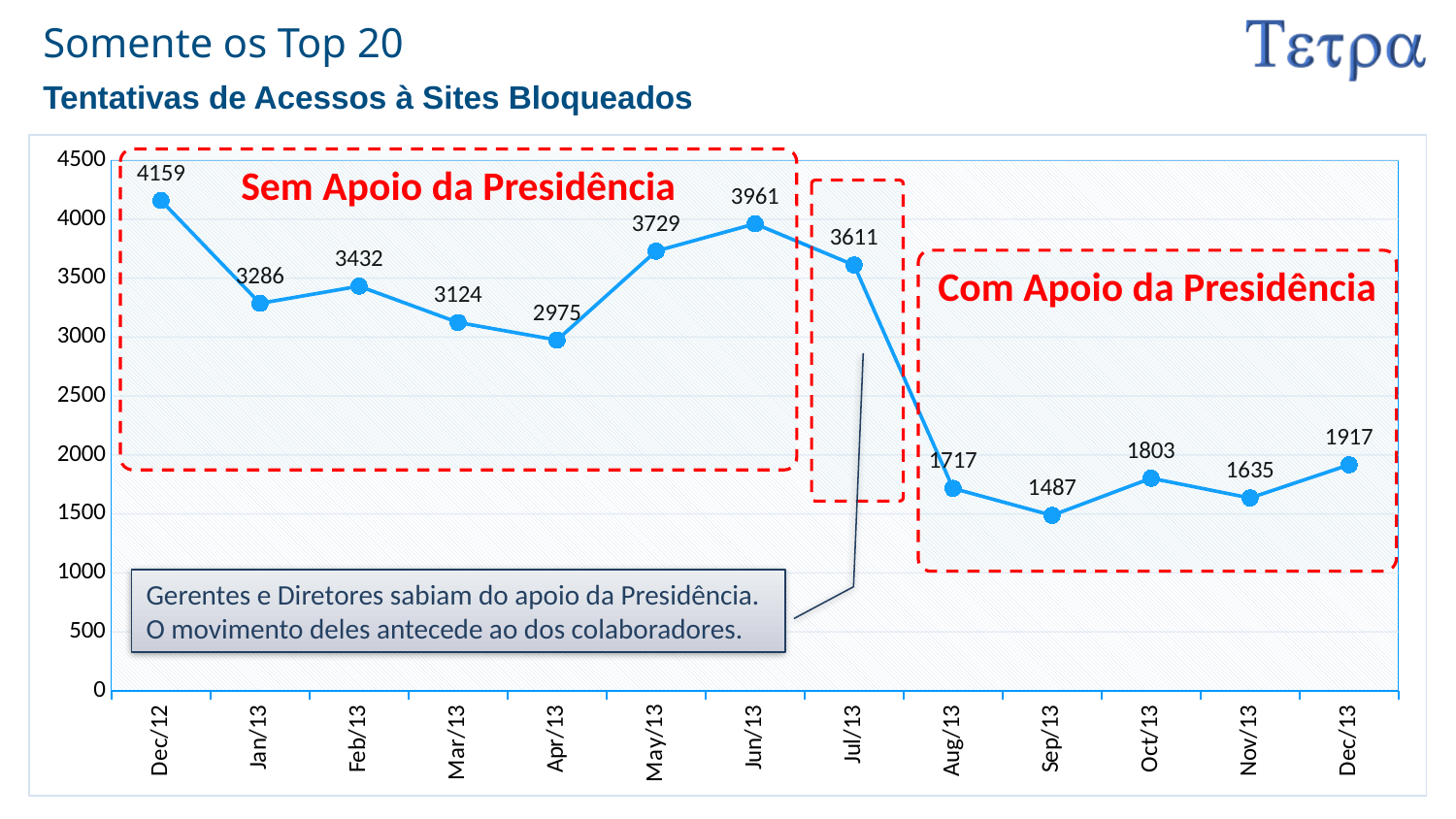
What kind of chart is shown? line chart Which is larger, the value for Feb/13 or the value for Mar/13? Feb/13 Is the value for Jun/13 greater or less than 3500? greater What is the value for Dec/12? 4159 Which month has the highest value? Dec/12 What is the value for Sep/13? 1487 Which month has the lowest value? Sep/13 How many months are plotted on the x axis? 13 What is the title of the chart? Tentativas de Acessos à Sites Bloqueados What is the value for Jul/13? 3611 Do the values rise or fall from Jul/13 to Aug/13? fall What is the difference between the values for Jul/13 and Aug/13? 1894